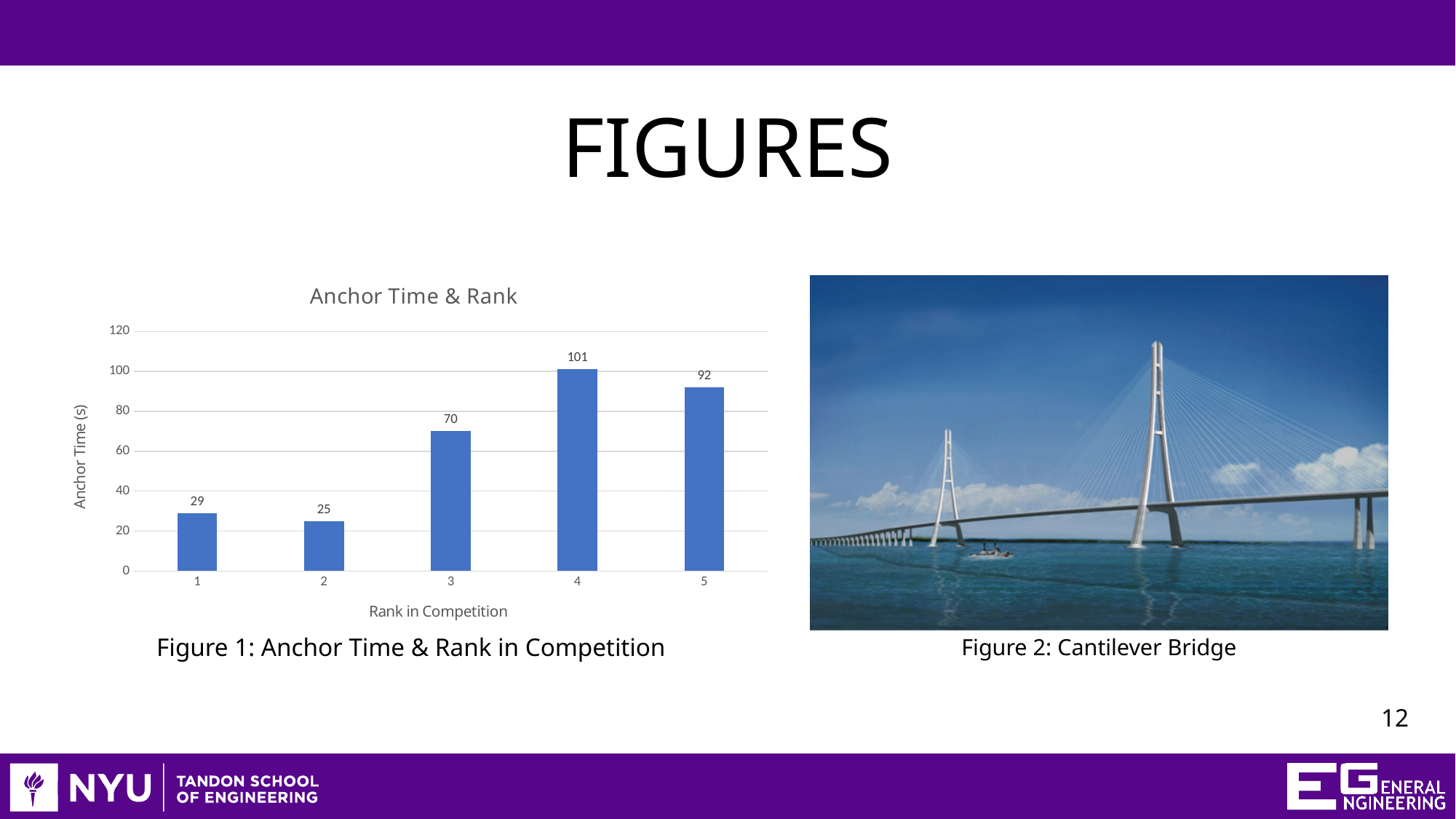
Which rank has the highest anchor time in the Anchor Time & Rank chart? 4 What type of chart is the Anchor Time & Rank chart? Bar chart Which has a larger anchor time in the Anchor Time & Rank chart, rank 1 or rank 2? Rank 1 What is the y-axis label of the Anchor Time & Rank chart? Anchor Time (s) Which rank has the lowest anchor time in the Anchor Time & Rank chart? 2 What is the anchor time for rank 4 in the Anchor Time & Rank chart? 101 What is the anchor time for rank 1 in the Anchor Time & Rank chart? 29 Is the anchor time for rank 3 greater or less than 60 in the Anchor Time & Rank chart? greater What is the anchor time for rank 5 in the Anchor Time & Rank chart? 92 What is the difference in anchor time between rank 3 and rank 2 in the Anchor Time & Rank chart? 45 How many ranks are plotted in the Anchor Time & Rank chart? 5 What is the difference in anchor time between rank 4 and rank 5 in the Anchor Time & Rank chart? 9